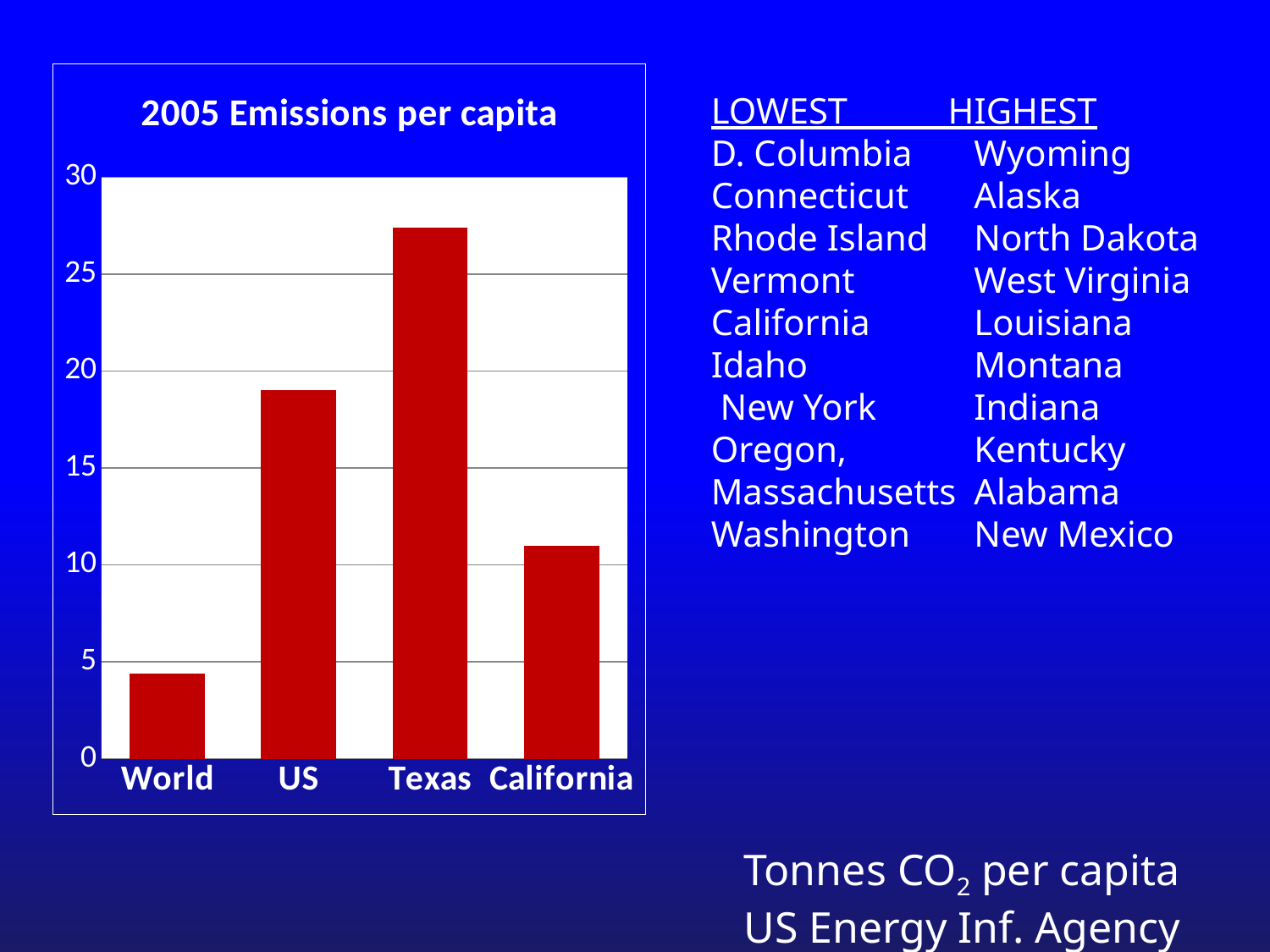
Is the value for World greater or less than 5? less Which category has the lowest emissions per capita in the chart? World How many categories are plotted in the chart? 4 Is the value for Texas greater or less than 25? greater Which is larger, the value for World or the value for California? California Is the value for California greater or less than 10? greater Which is larger, the value for US or the value for California? US What is the maximum value shown on the vertical axis of the chart? 30 Which category has the highest emissions per capita in the chart? Texas What type of chart is shown on the slide? bar chart What is the title of the chart? 2005 Emissions per capita